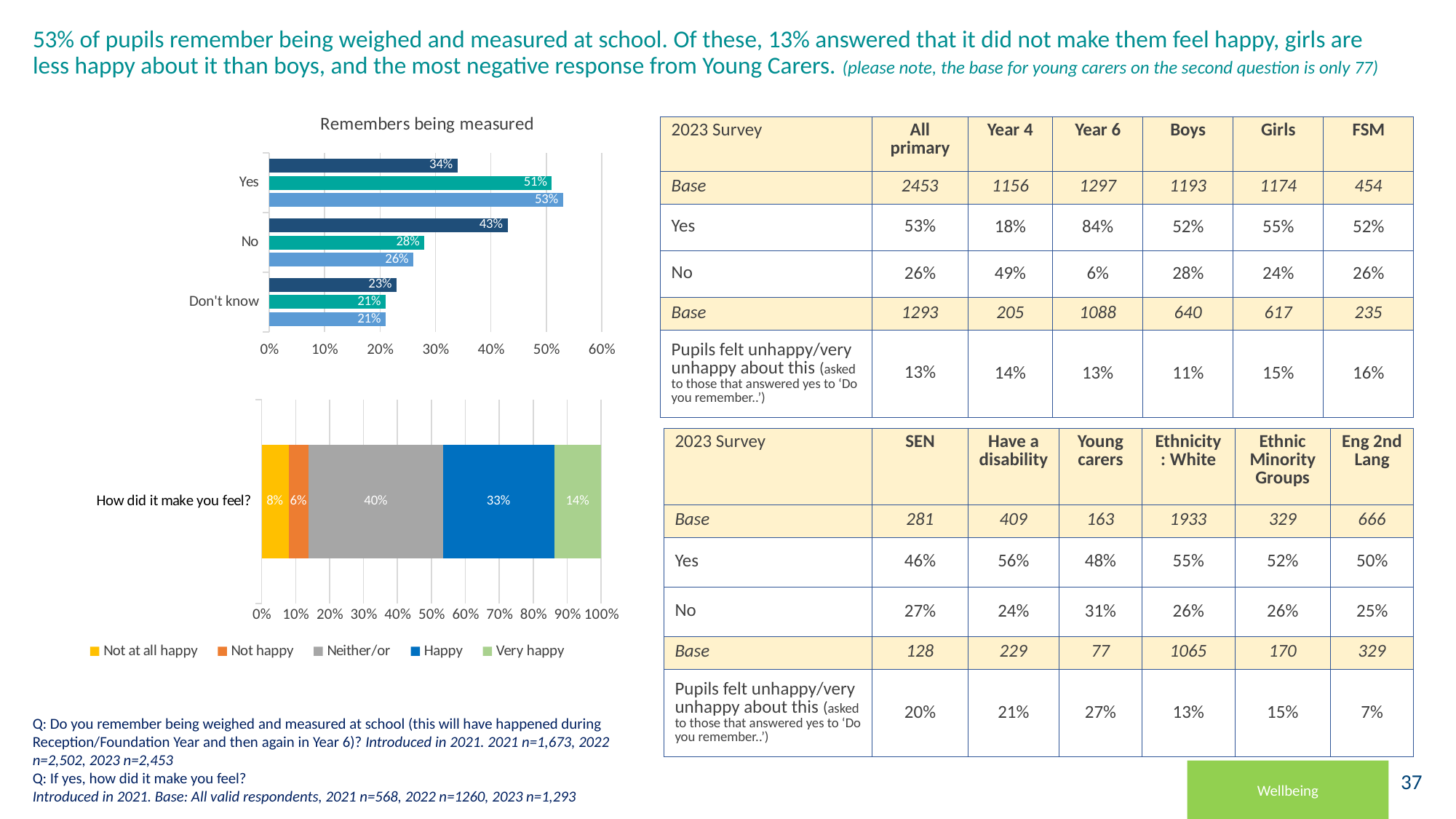
How many categories are shown on the y axis of the 'Remembers being measured' chart? 3 In the 'How did it make you feel?' chart, which response has the smallest segment? Not happy How many series does the legend of the 'How did it make you feel?' chart list? 5 In the 'Remembers being measured' chart, which category has the longest light blue bar? Yes In the 'How did it make you feel?' chart, what percentage answered 'Very happy'? 14% In the 'Remembers being measured' chart, what is the value of the light blue (bottom) bar for 'Yes'? 53% In the 'How did it make you feel?' chart, what is the difference between the 'Happy' segment (33%) and the 'Very happy' segment (14%)? 19 percentage points In the 'Remembers being measured' chart, what is the value of the dark blue (top) bar for 'No'? 43% What kind of chart is the 'Remembers being measured' chart? Bar chart In the 'How did it make you feel?' chart, what percentage answered 'Neither/or'? 40% In the 'Remembers being measured' chart, is the teal bar for 'Yes' larger or smaller than the teal bar for 'No'? Larger In the 'Remembers being measured' chart, what is the difference between the dark blue bar (43%) and the light blue bar (26%) for 'No'? 17 percentage points